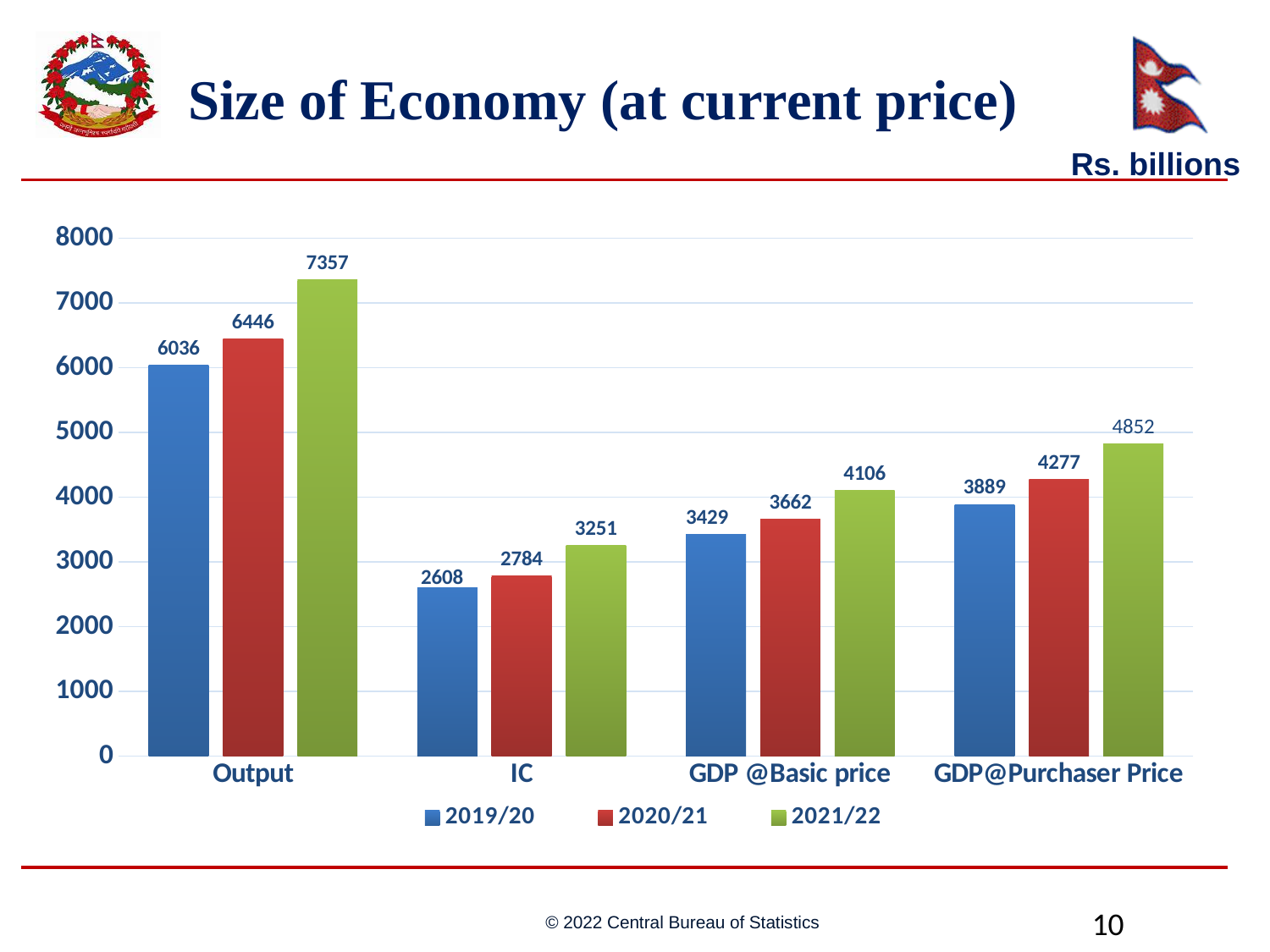
What kind of chart is shown on the slide? Bar chart What is the value for Output in 2021/22? 7357 Which category has the lowest value in 2021/22? IC How many series does the legend list? 3 What is the value for GDP@Purchaser Price in 2021/22? 4852 What is the value for IC in 2019/20? 2608 Which is larger: GDP@Purchaser Price in 2019/20 or GDP @Basic price in 2021/22? GDP @Basic price in 2021/22 Which category has the highest value in 2019/20? Output What is the value for GDP @Basic price in 2020/21? 3662 What is the difference between the Output values for 2021/22 and 2019/20? 1321 Do the values for IC rise or fall from 2019/20 to 2021/22? Rise How many categories are shown on the x axis? 4